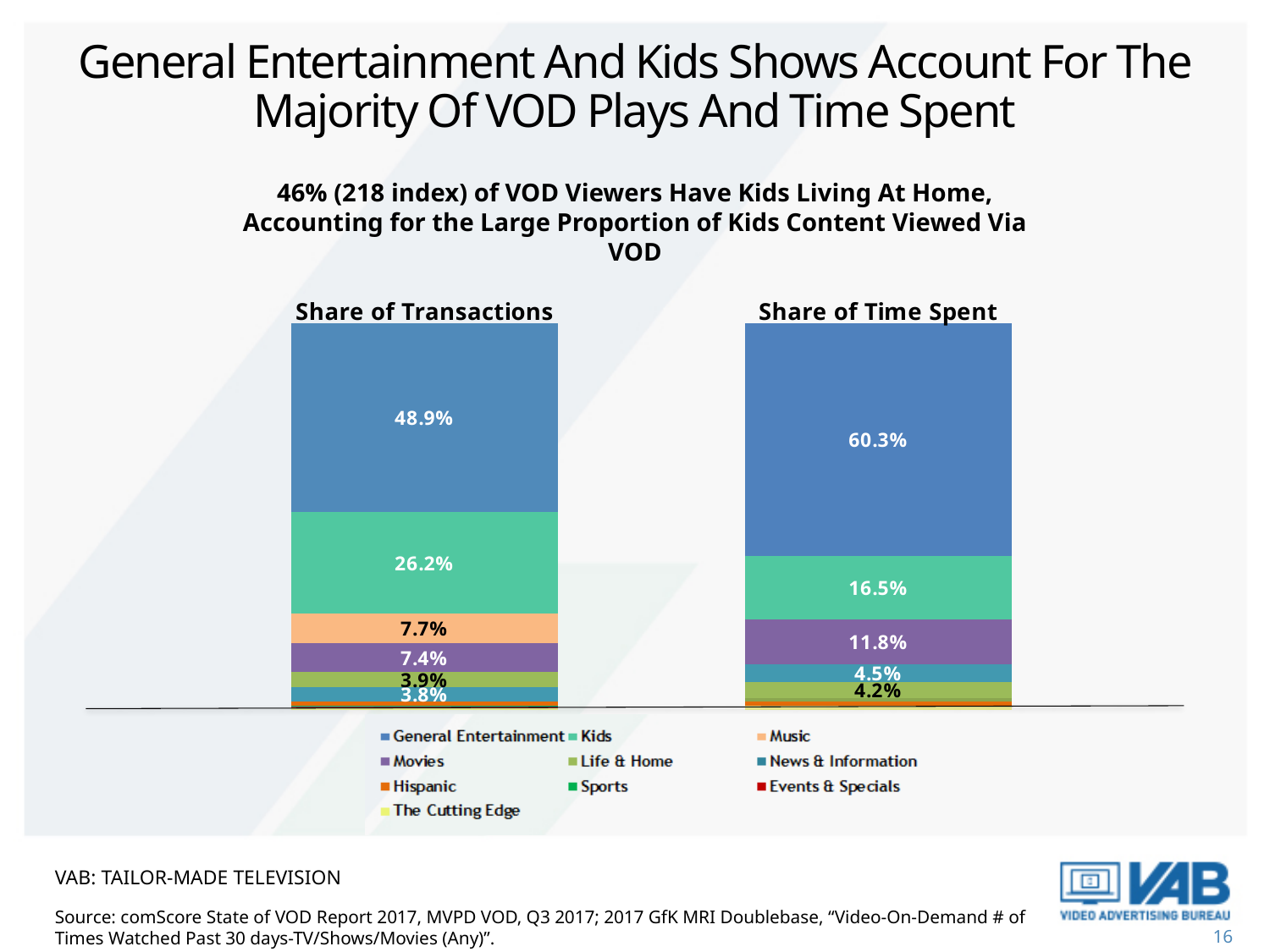
What is the difference between the General Entertainment values in the Share of Time Spent and Share of Transactions bars? 11.4% How many categories does the legend list? 10 Is the Kids value larger in the Share of Transactions bar or the Share of Time Spent bar? Share of Transactions What is the Kids value in the Share of Time Spent bar? 16.5% What is the General Entertainment value in the Share of Time Spent bar? 60.3% What is the difference between the Kids values in the Share of Transactions and Share of Time Spent bars? 9.7% How many bars are plotted in the chart? 2 What is the Movies value in the Share of Transactions bar? 7.4% What is the Music value in the Share of Transactions bar? 7.7% What kind of chart is shown on the slide? Stacked bar chart What is the General Entertainment value in the Share of Transactions bar? 48.9% Which category has the largest segment in the Share of Time Spent bar? General Entertainment